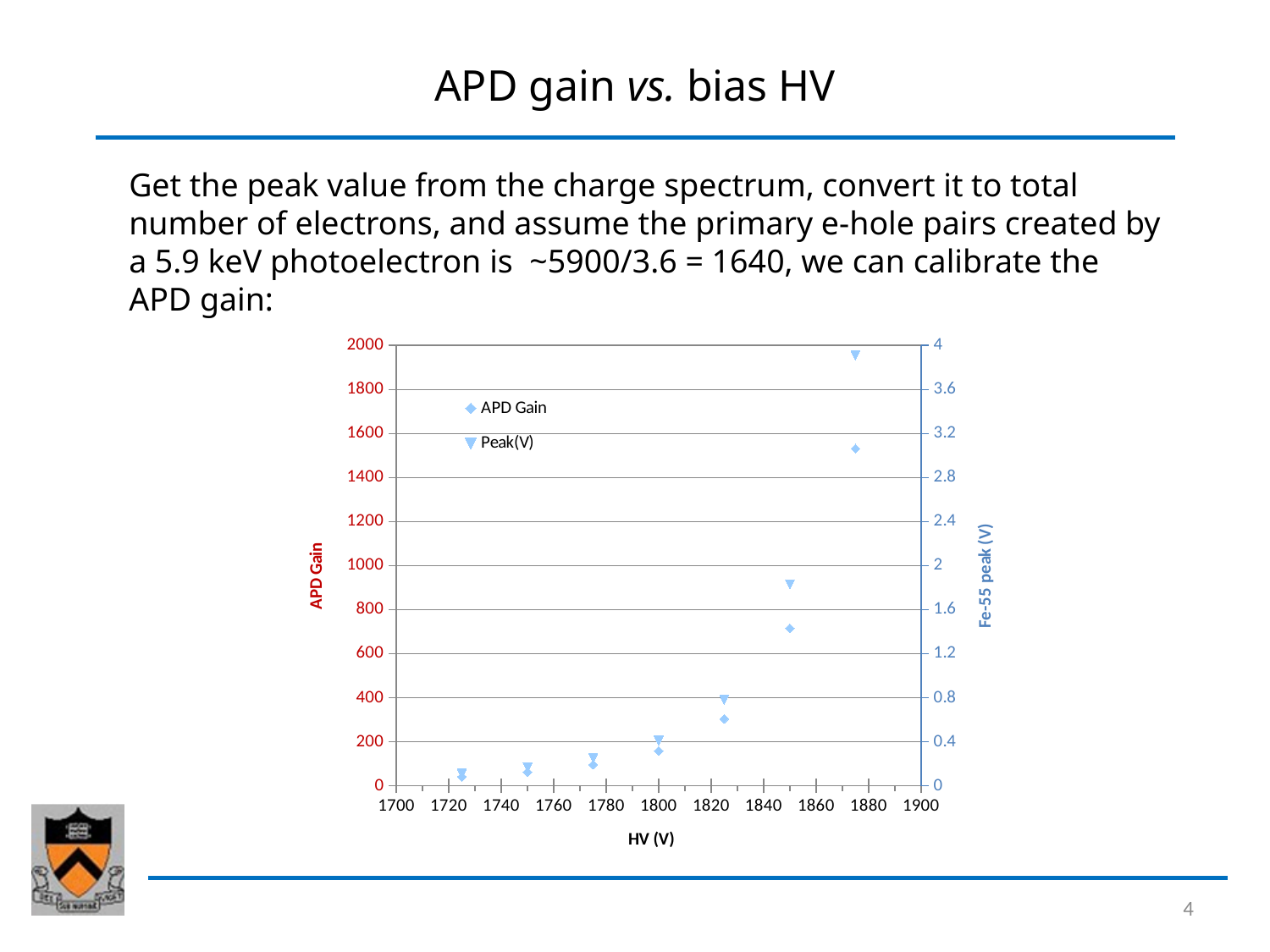
What kind of chart is shown on the slide? scatter chart Is the APD Gain at HV 1875 greater or less than 1400? greater What is the title of the chart's x axis? HV (V) How many data points are plotted for the APD Gain series? 7 Which is larger, the APD Gain at HV 1850 or the APD Gain at HV 1825? HV 1850 Is the APD Gain at HV 1850 greater or less than 800? less Does the APD Gain rise or fall as HV increases along the x axis? rise Is the Peak(V) value at HV 1875 greater or less than 3.6? greater What are the two series named in the chart legend? APD Gain and Peak(V) How many series does the chart legend list? 2